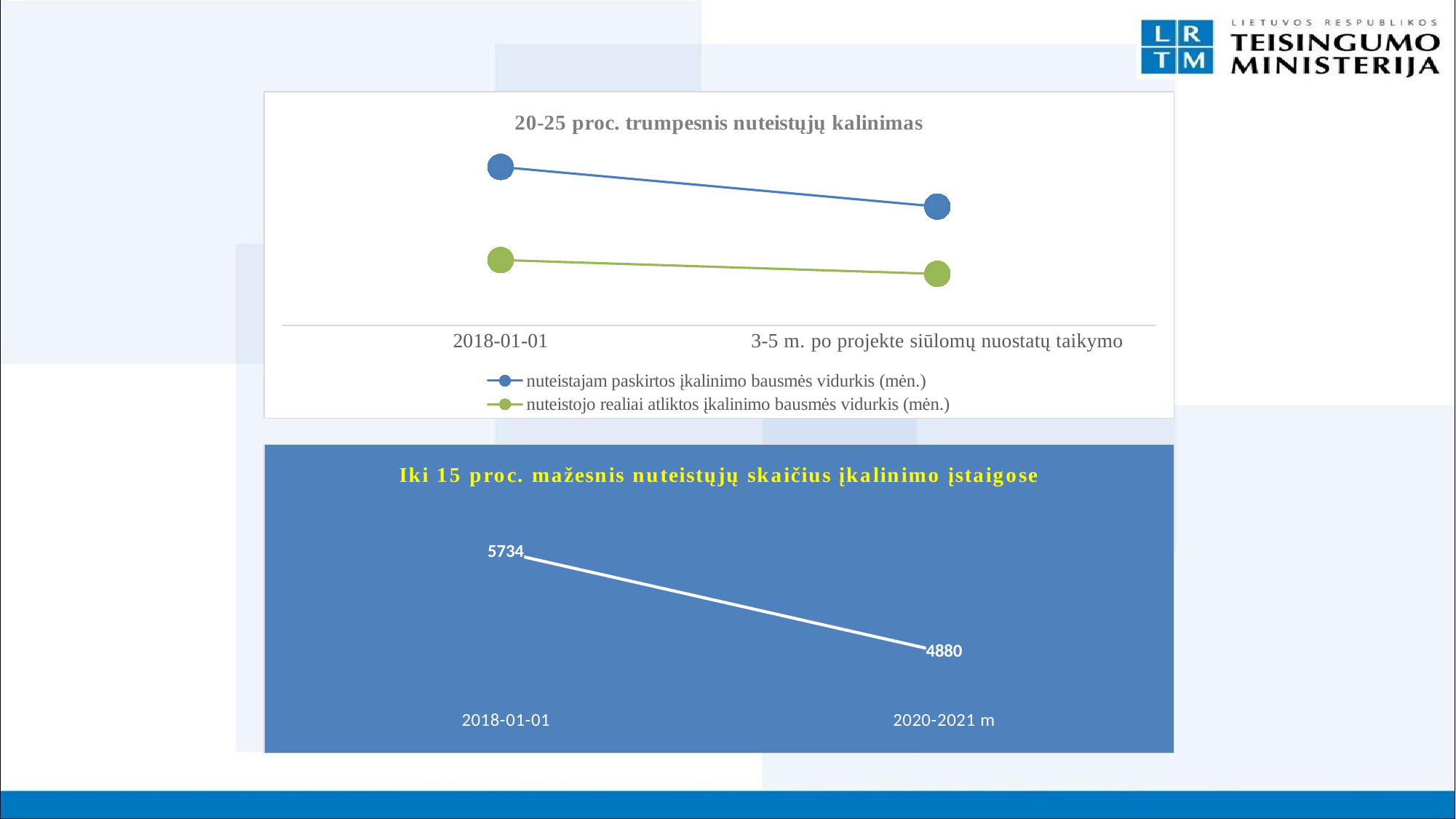
In the top chart, do the values of the series 'nuteistajam paskirtos įkalinimo bausmės vidurkis (mėn.)' rise or fall along the x axis? fall What kind of chart is the bottom chart? line chart In the bottom chart, what is the value for 2018-01-01? 5734 In the top chart, at 2018-01-01, which series has the larger value: 'nuteistajam paskirtos įkalinimo bausmės vidurkis (mėn.)' or 'nuteistojo realiai atliktos įkalinimo bausmės vidurkis (mėn.)'? nuteistajam paskirtos įkalinimo bausmės vidurkis (mėn.) In the bottom chart, which category has the higher value? 2018-01-01 In the bottom chart, what is the value for 2020-2021 m? 4880 How many series does the legend of the top chart list? 2 How many categories are shown on the x axis of the top chart? 2 In the bottom chart, which category has the lower value? 2020-2021 m In the bottom chart, do the values rise or fall from 2018-01-01 to 2020-2021 m? fall What is the title of the top chart? 20-25 proc. trumpesnis nuteistųjų kalinimas In the bottom chart, what is the difference between the value for 2018-01-01 and the value for 2020-2021 m? 854